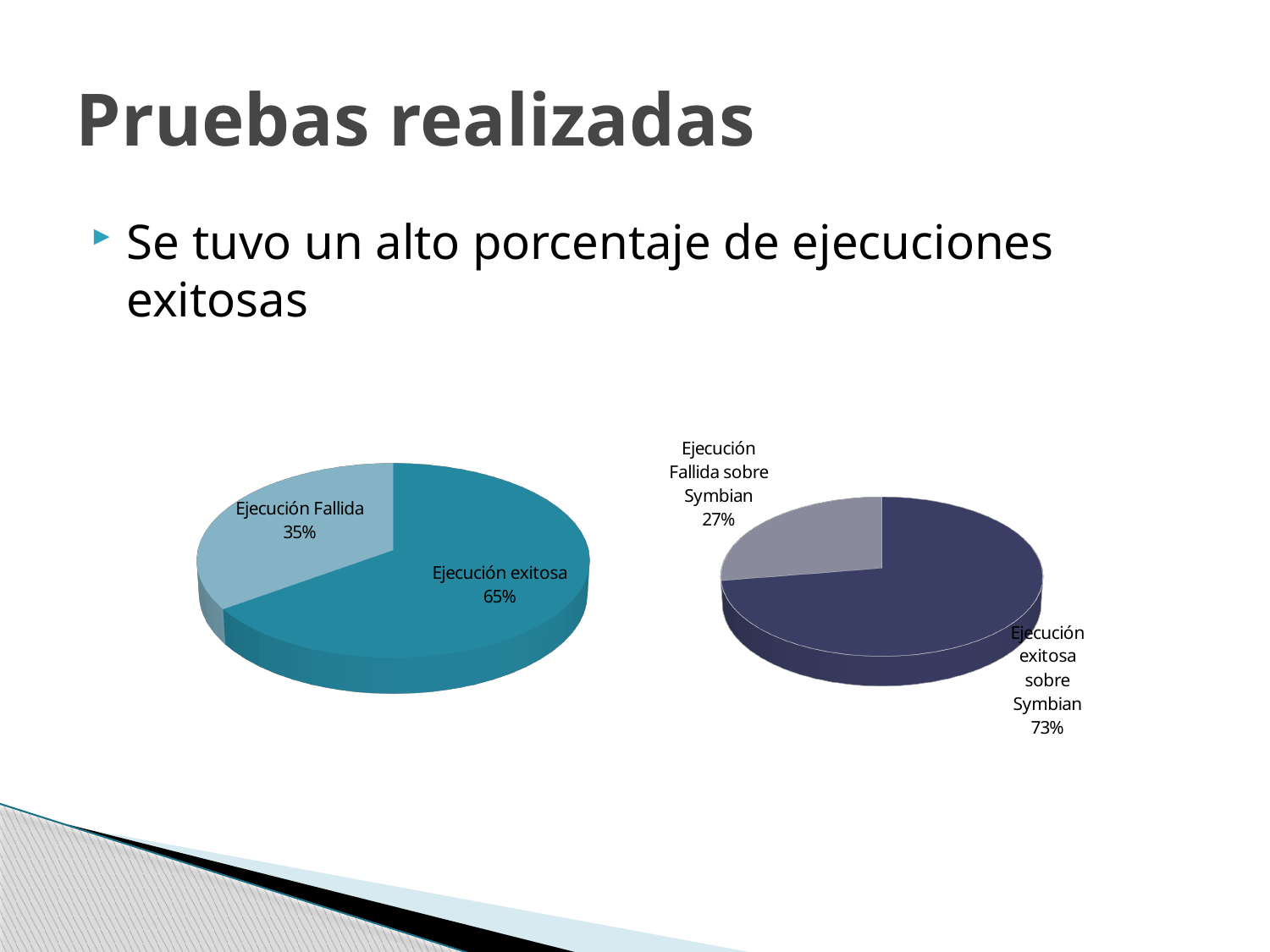
In the right pie chart, what is the share for Ejecución exitosa sobre Symbian? 73% In the left pie chart, what is the share for Ejecución Fallida? 35% In the right pie chart, which slice is the smallest? Ejecución Fallida sobre Symbian Which is larger: Ejecución exitosa in the left pie chart or Ejecución exitosa sobre Symbian in the right pie chart? Ejecución exitosa sobre Symbian In the left pie chart, which slice is the largest? Ejecución exitosa How many charts are shown on the slide? 2 In the left pie chart, what is the share for Ejecución exitosa? 65% In the left pie chart, what is the difference between the Ejecución exitosa and Ejecución Fallida shares? 30% What type of chart is the right chart on the slide? Pie chart How many slices does the left pie chart have? 2 In the right pie chart, what is the difference between the Ejecución exitosa sobre Symbian and Ejecución Fallida sobre Symbian shares? 46% In the right pie chart, what is the share for Ejecución Fallida sobre Symbian? 27%